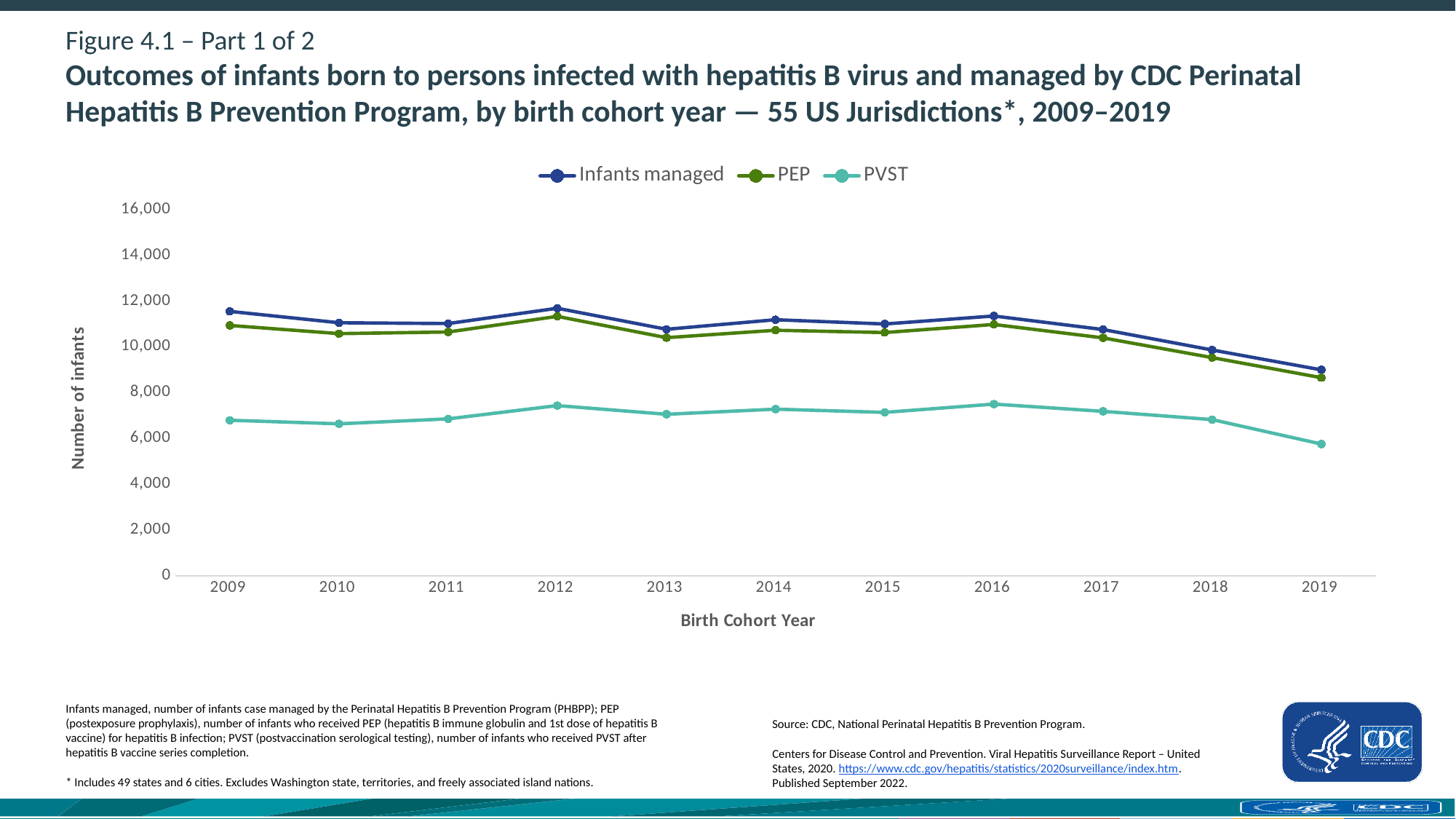
Do the PVST values rise or fall from 2016 to 2019? Fall Is the value for Infants managed in 2009 greater or less than 10,000? greater How many series does the legend list? 3 What is the label of the y axis? Number of infants How many birth cohort years are plotted along the x axis? 11 In 2015, which is larger: the value for Infants managed or the value for PVST? Infants managed Is the value for PEP in 2018 greater or less than 10,000? less In which birth cohort year is the PVST value lowest? 2019 Is the value for PVST in 2019 greater or less than 6,000? less What kind of chart is shown on the slide? Line chart In which birth cohort year is the Infants managed value lowest? 2019